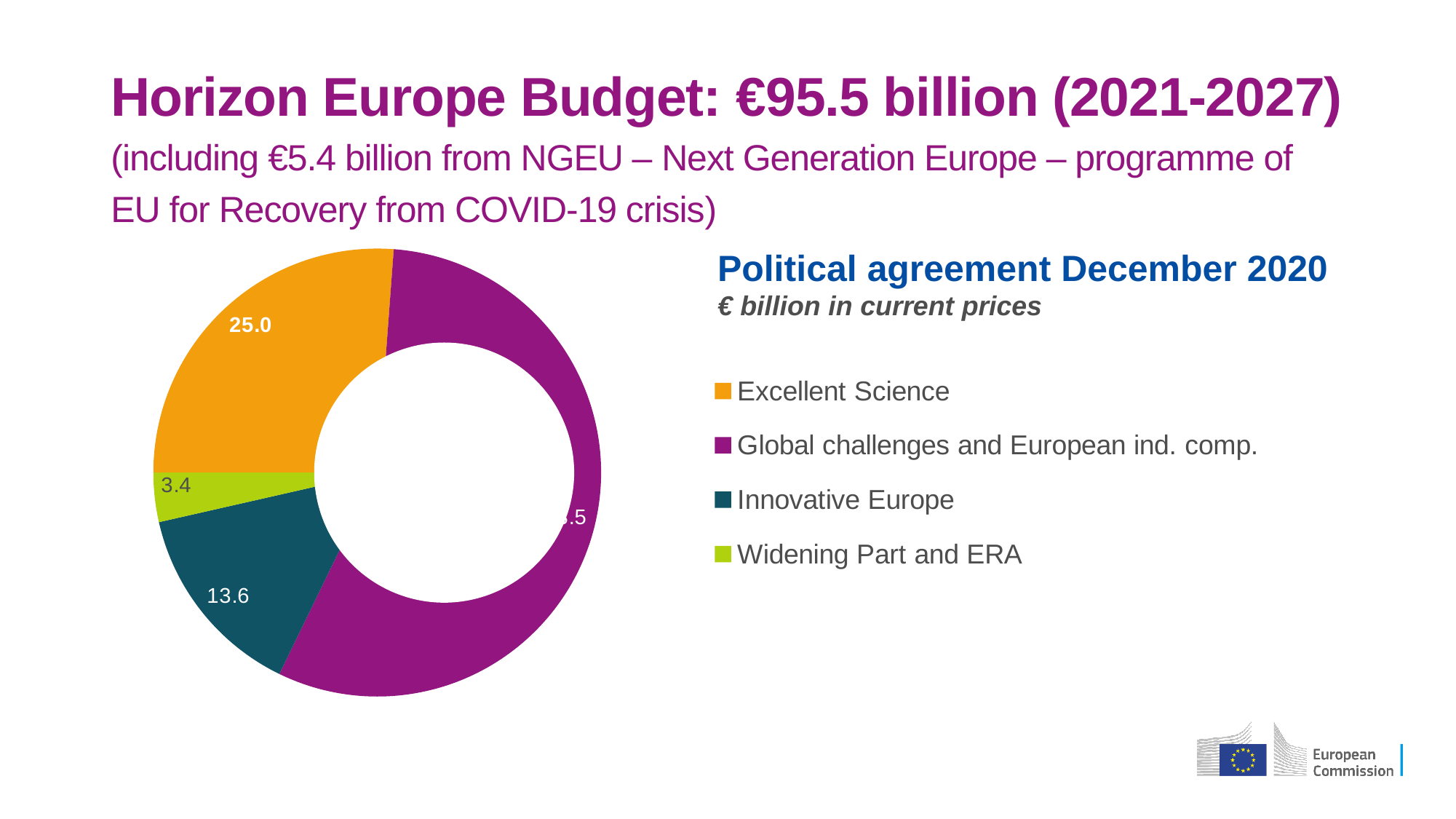
Which category has the largest slice of the chart? Global challenges and European ind. comp. Which category has the smallest slice of the chart? Widening Part and ERA How many categories are shown in the chart? 4 Which is larger, the value for Excellent Science or the value for Innovative Europe? Excellent Science How many entries does the legend list? 4 What is the value shown for Excellent Science? 25.0 What kind of chart is shown on the slide? Pie (doughnut) chart In what unit are the chart values expressed, according to the slide? € billion in current prices What is the difference between the values for Excellent Science and Innovative Europe? 11.4 What is the value shown for Innovative Europe? 13.6 What is the difference between the values for Innovative Europe and Widening Part and ERA? 10.2 What is the value shown for Widening Part and ERA? 3.4